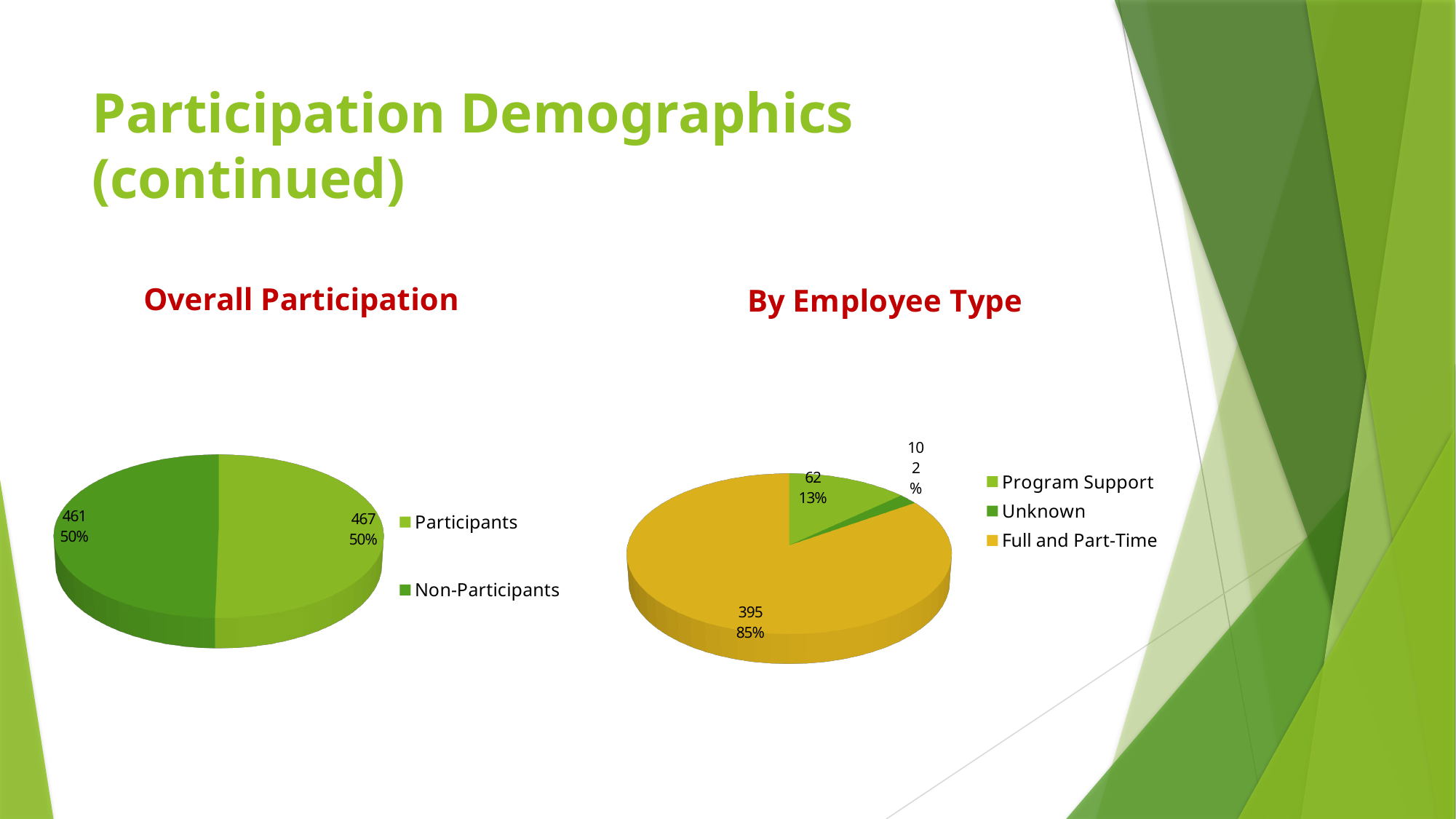
In the By Employee Type chart, what percentage share is shown for Unknown? 2% In the By Employee Type chart, what is the difference between the Full and Part-Time and Program Support values? 333 In the Overall Participation chart, what percentage share is shown for Non-Participants? 50% In the By Employee Type chart, what is the value for Full and Part-Time? 395 In the Overall Participation chart, what is the value for Participants? 467 In the By Employee Type chart, what is the value for Program Support? 62 In the By Employee Type chart, which category has the largest slice? Full and Part-Time In the Overall Participation chart, what is the value for Non-Participants? 461 How many categories does the legend of the By Employee Type chart list? 3 In the By Employee Type chart, which category has the smallest slice? Unknown What kind of chart is the Overall Participation chart? Pie chart In the Overall Participation chart, what is the difference between the Participants and Non-Participants values? 6